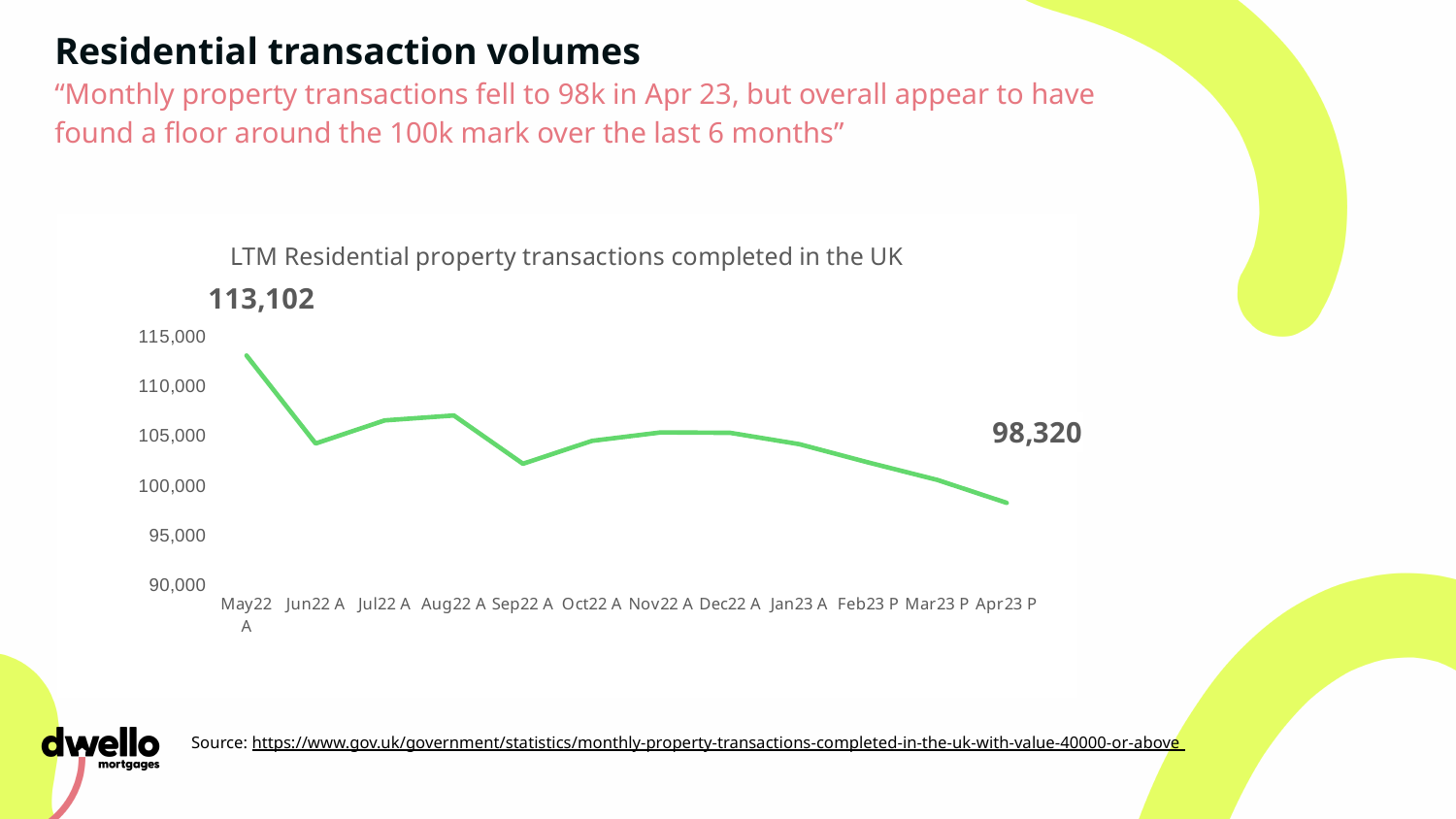
What type of chart is shown on the slide? line chart What is the title of the chart? LTM Residential property transactions completed in the UK How many months are plotted on the x axis? 12 Is the value for Aug22 A greater or less than 105,000? greater Which month has the highest value? May22 A Overall, do the values rise or fall from May22 A to Apr23 P? fall What is the value for May22 A? 113,102 What is the value for Apr23 P? 98,320 Which month has the lowest value? Apr23 P What is the difference between the values for May22 A and Apr23 P? 14,782 Which is larger, the value for May22 A or the value for Apr23 P? May22 A Is the value for Sep22 A greater or less than 105,000? less